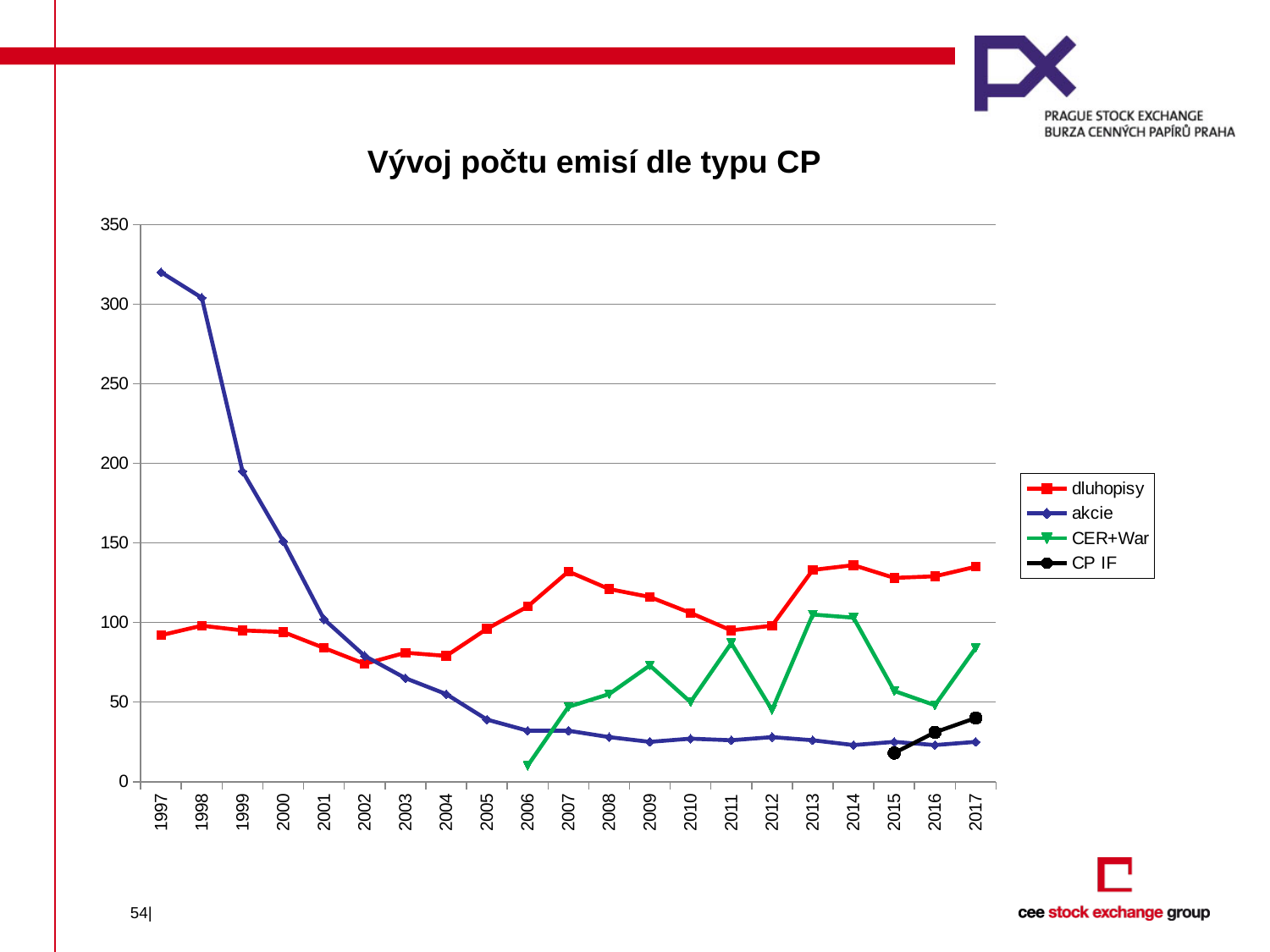
Which series has the highest value in 1997? akcie What is the title of the chart? Vývoj počtu emisí dle typu CP Do the values for akcie rise or fall from 1997 to 2005? fall Is the value for dluhopisy in 2007 greater or less than 100? greater Is the value for akcie in 1997 greater or less than 300? greater Which is larger in 2013, dluhopisy or CER+War? dluhopisy Is the value for CP IF in 2017 greater or less than 50? less How many years are shown on the x axis? 21 What kind of chart is shown on the slide? line chart How many series does the legend list? 4 Which series has the lowest value in 2017? akcie